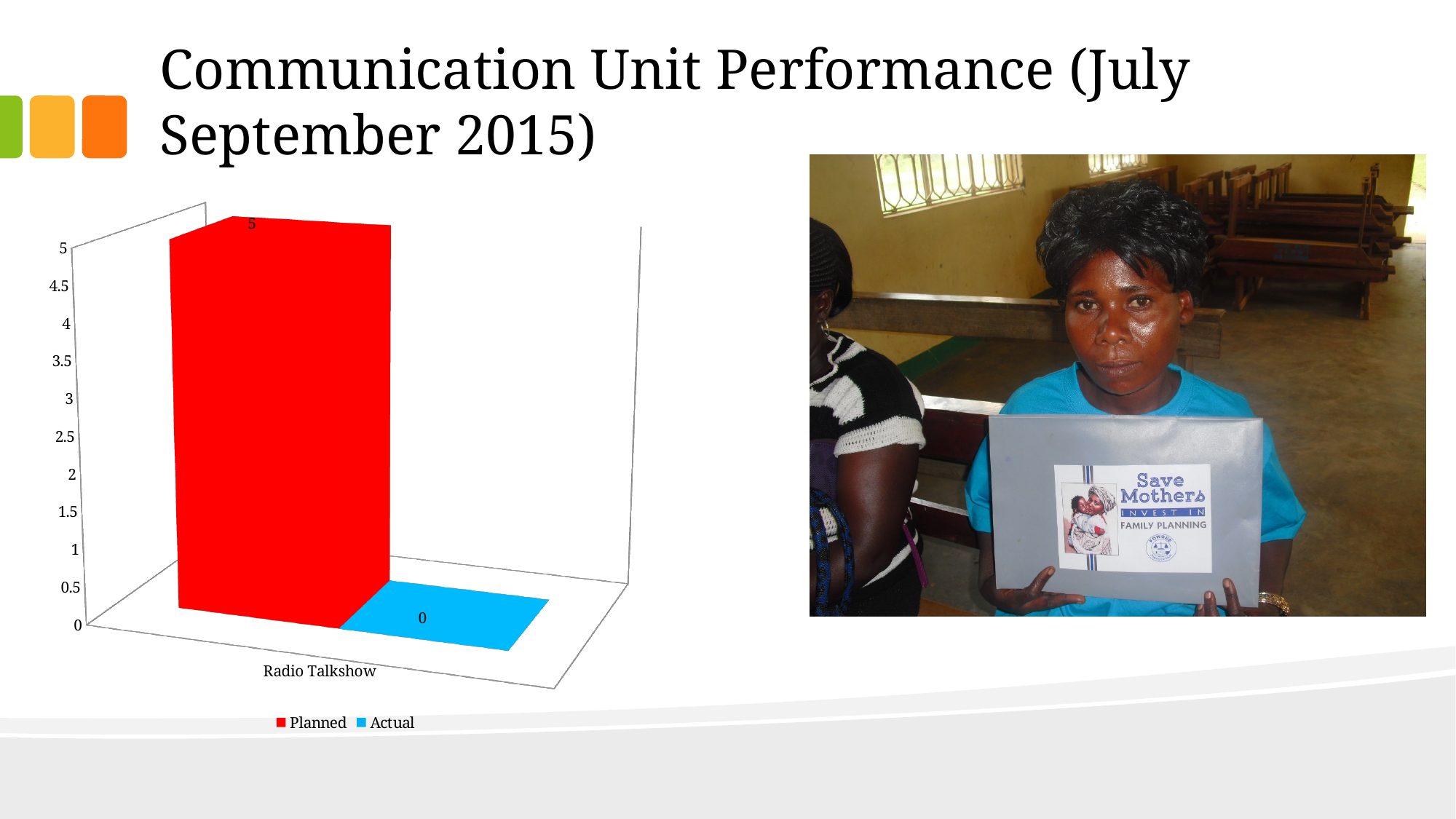
How many categories are shown on the x axis? 1 How many series does the legend list? 2 Is the Planned value for Radio Talkshow greater or less than 2.5? greater Which series is shown in blue in the legend? Actual What kind of chart is shown on the slide? bar chart Which series has the higher value for Radio Talkshow, Planned or Actual? Planned Which series is shown in red in the legend? Planned What is the highest value shown on the vertical axis? 5 What is the Planned value for Radio Talkshow? 5 What is the Actual value for Radio Talkshow? 0 What is the difference between the Planned and Actual values for Radio Talkshow? 5